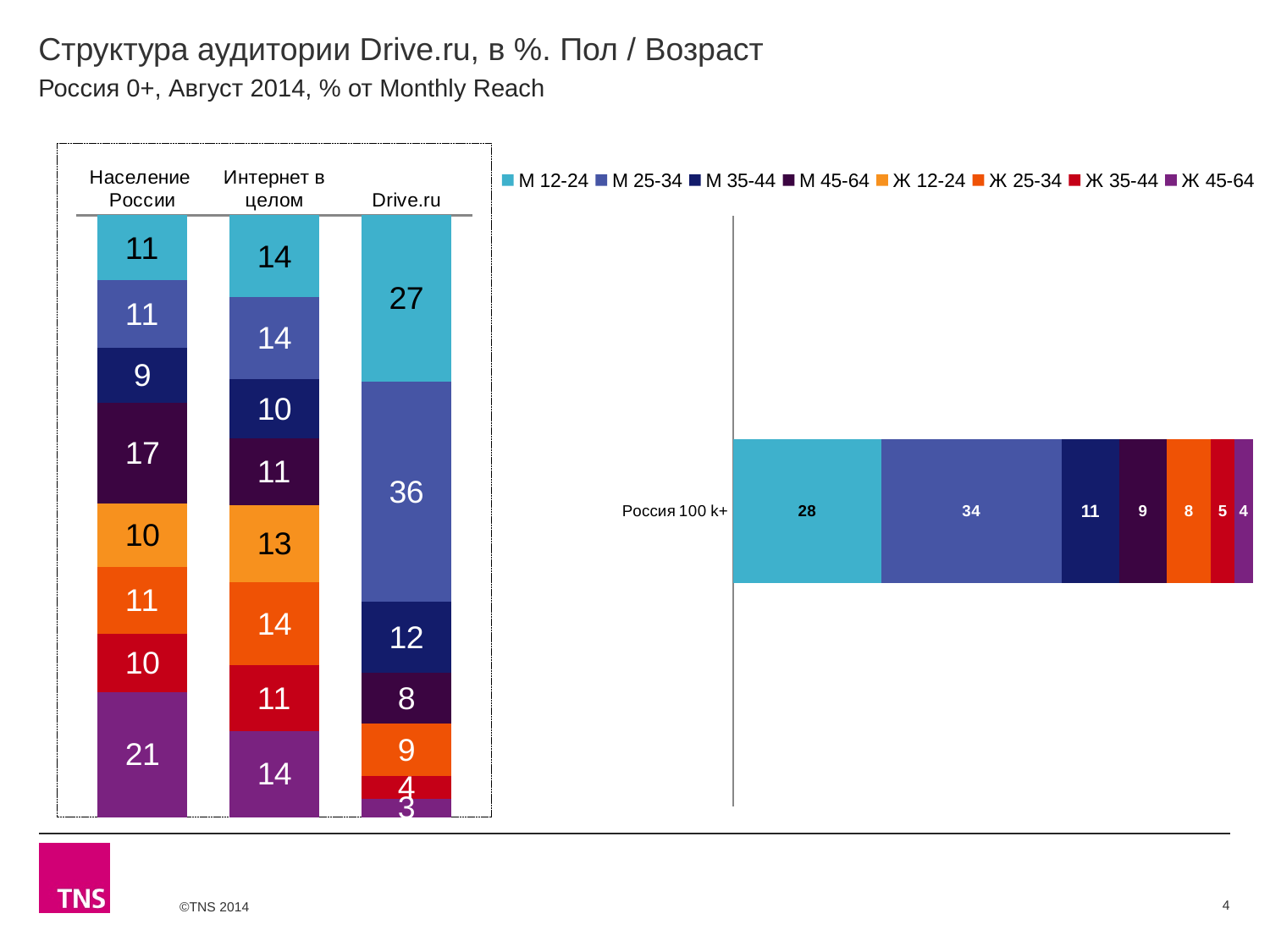
In the left chart, what is the value for М 12-24 in the Интернет в целом bar? 14 In the left chart, which segment of the Население России bar is the largest? Ж 45-64 In the left chart, what is the value for Ж 45-64 in the Население России bar? 21 What kind of chart is the right chart (Россия 100 k+)? Stacked bar chart In the left chart, which segment of the Drive.ru bar is the largest? М 25-34 In the right chart, what is the value for М 25-34 in the Россия 100 k+ bar? 34 In the left chart, what is the difference between the М 25-34 value for Drive.ru and the М 25-34 value for Население России? 25 How many series does the legend list? 8 In the left chart, what is the value for М 25-34 in the Drive.ru bar? 36 In the left chart, which is larger: the М 12-24 value for Drive.ru or the М 12-24 value for Интернет в целом? Drive.ru How many bars (categories) does the left chart show? 3 In the left chart, what is the value for М 45-64 in the Население России bar? 17